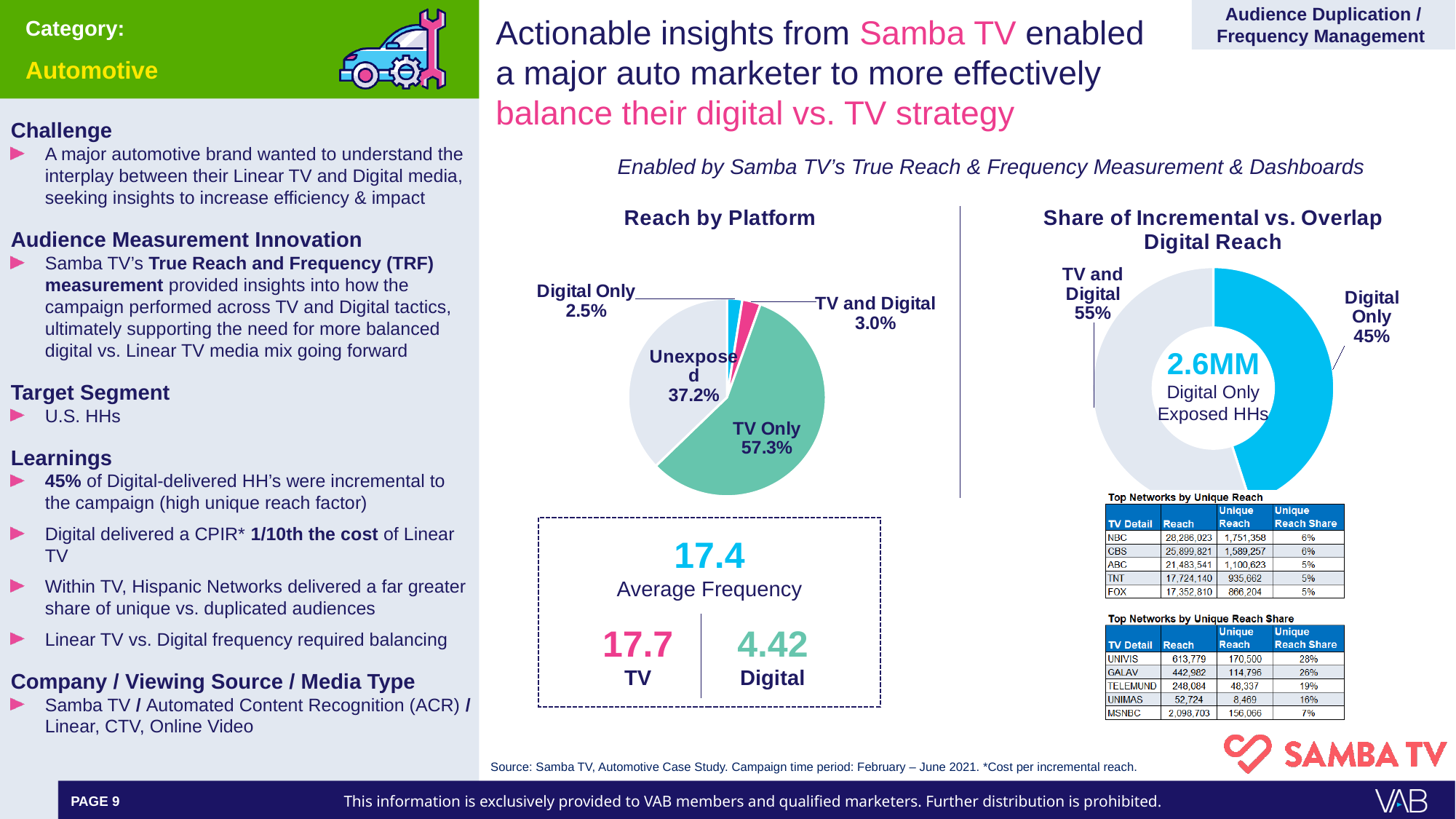
In the Reach by Platform chart, which is larger, TV and Digital or Digital Only? TV and Digital What kind of chart is the Reach by Platform chart? Pie chart In the Reach by Platform chart, what share is Digital Only? 2.5% In the Reach by Platform chart, which category has the smallest share? Digital Only In the Reach by Platform chart, which category has the largest share? TV Only In the Share of Incremental vs. Overlap Digital Reach chart, what share is Digital Only? 45% How many slices does the Reach by Platform chart have? 4 In the Reach by Platform chart, what is the difference between the TV Only and Unexposed shares? 20.1% In the Share of Incremental vs. Overlap Digital Reach chart, which segment is larger, TV and Digital or Digital Only? TV and Digital What value is shown in the center of the Share of Incremental vs. Overlap Digital Reach chart? 2.6MM In the Reach by Platform chart, what share is TV Only? 57.3% In the Reach by Platform chart, what share is Unexposed? 37.2%